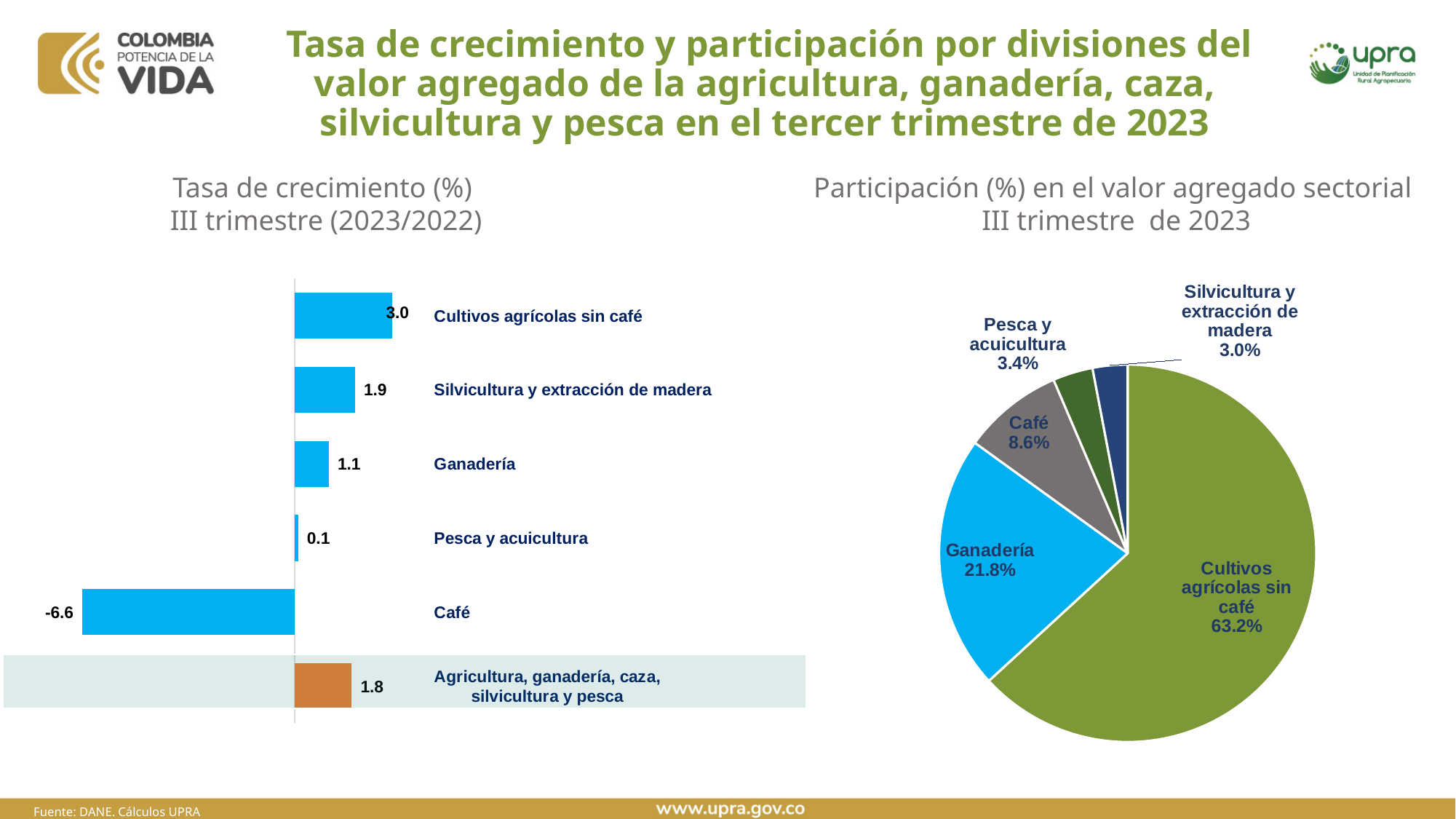
In the bar chart 'Tasa de crecimiento (%) III trimestre (2023/2022)', which category has the lowest growth rate? Café In the bar chart 'Tasa de crecimiento (%) III trimestre (2023/2022)', what is the difference between the growth rates of Silvicultura y extracción de madera and Ganadería? 0.8 In the bar chart 'Tasa de crecimiento (%) III trimestre (2023/2022)', how many categories are shown? 6 In the pie chart 'Participación (%) en el valor agregado sectorial III trimestre de 2023', which is larger: the share of Café or the share of Pesca y acuicultura? Café In the bar chart 'Tasa de crecimiento (%) III trimestre (2023/2022)', what is the growth rate for Cultivos agrícolas sin café? 3.0 In the pie chart 'Participación (%) en el valor agregado sectorial III trimestre de 2023', what is the share of Ganadería? 21.8% In the bar chart 'Tasa de crecimiento (%) III trimestre (2023/2022)', what is the growth rate for Agricultura, ganadería, caza, silvicultura y pesca? 1.8 What type of chart is the one on the left titled 'Tasa de crecimiento (%) III trimestre (2023/2022)'? Bar chart In the bar chart 'Tasa de crecimiento (%) III trimestre (2023/2022)', what is the growth rate for Café? -6.6 In the pie chart 'Participación (%) en el valor agregado sectorial III trimestre de 2023', which category has the largest share? Cultivos agrícolas sin café In the pie chart 'Participación (%) en el valor agregado sectorial III trimestre de 2023', how many slices are there? 5 In the bar chart 'Tasa de crecimiento (%) III trimestre (2023/2022)', which category has the highest growth rate? Cultivos agrícolas sin café